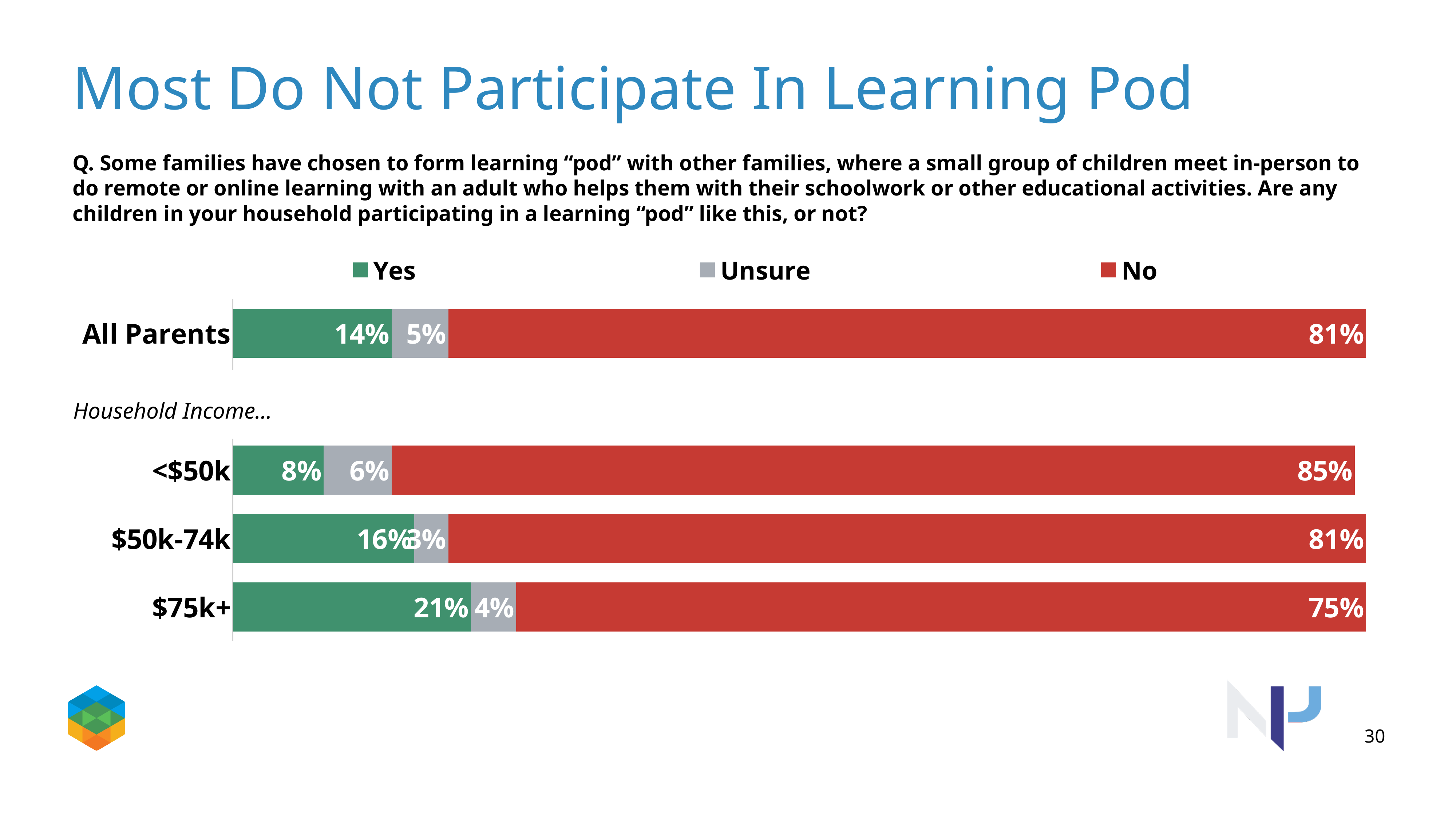
In the Household Income chart, what is the Yes value for $75k+? 21% In the Household Income chart, which income group has the lowest Yes value? <$50k What kind of chart is used on this slide? Stacked bar chart In the All Parents chart, what percentage of parents answered No? 81% In the Household Income chart, what is the difference between the Yes values for $75k+ and <$50k? 13 percentage points In the Household Income chart, is the No value larger for $50k-74k or for $75k+? $50k-74k How many series does the legend list? 3 Which colour represents the No responses in the charts? Red How many income groups are shown in the Household Income chart? 3 In the Household Income chart, what is the Unsure value for <$50k? 6% In the Household Income chart, which income group has the highest No value? <$50k In the All Parents chart, what percentage answered Yes? 14%